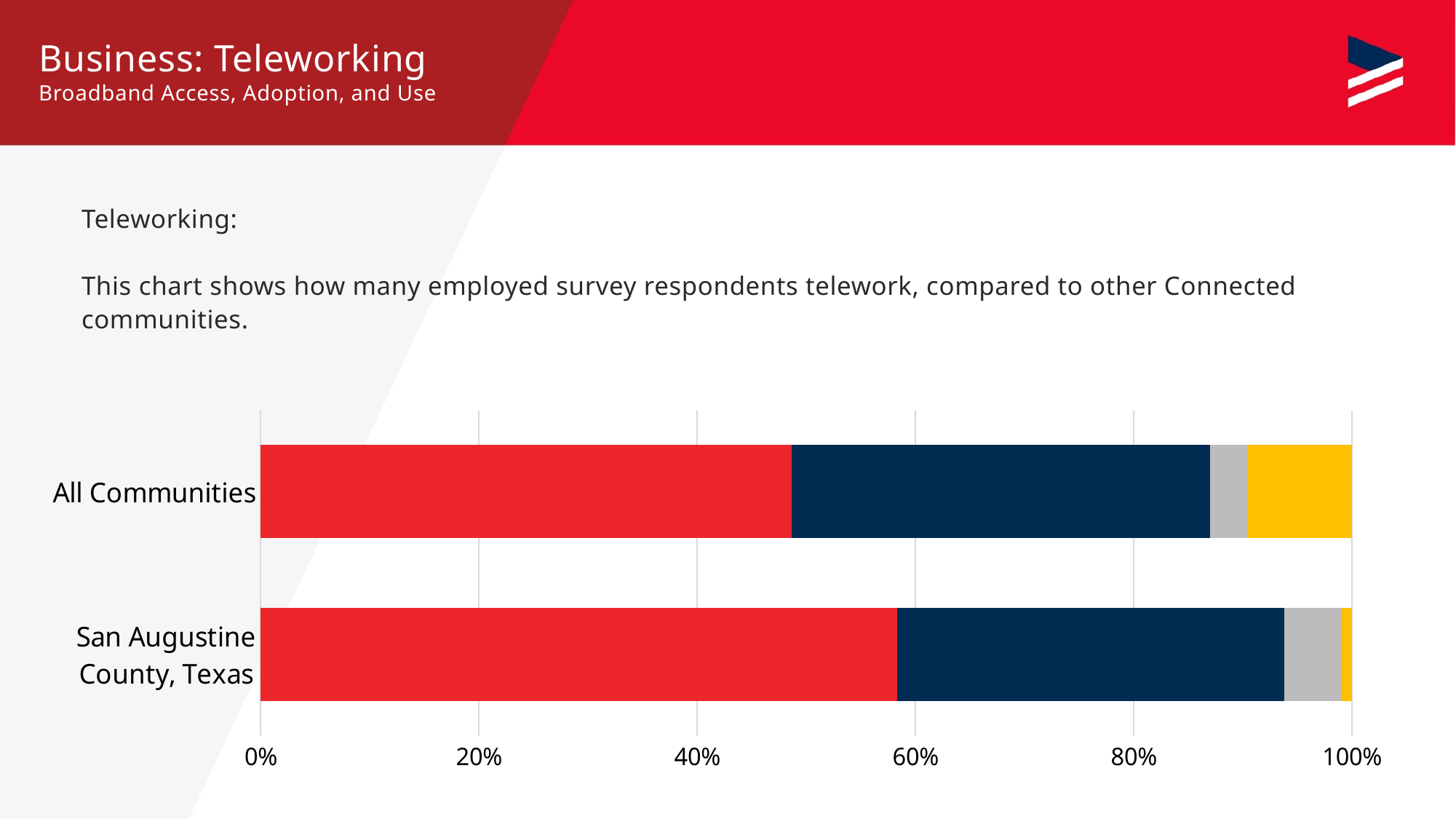
Which category has the larger red segment, All Communities or San Augustine County, Texas? San Augustine County, Texas Which category has the larger grey segment, All Communities or San Augustine County, Texas? San Augustine County, Texas How many categories (bars) does the chart show? 2 How many coloured segments make up each bar in the chart? 4 What kind of chart is shown on the slide? Stacked bar chart What is the highest value shown on the horizontal axis? 100% Which category has the larger yellow segment, All Communities or San Augustine County, Texas? All Communities Is the red segment for All Communities greater or less than 60%? less What colour is the first (leftmost) segment of each bar? Red Is the red segment for San Augustine County, Texas greater or less than 40%? greater What is the total of the stacked bar for All Communities? 100% Is the red segment for All Communities greater or less than 40%? greater